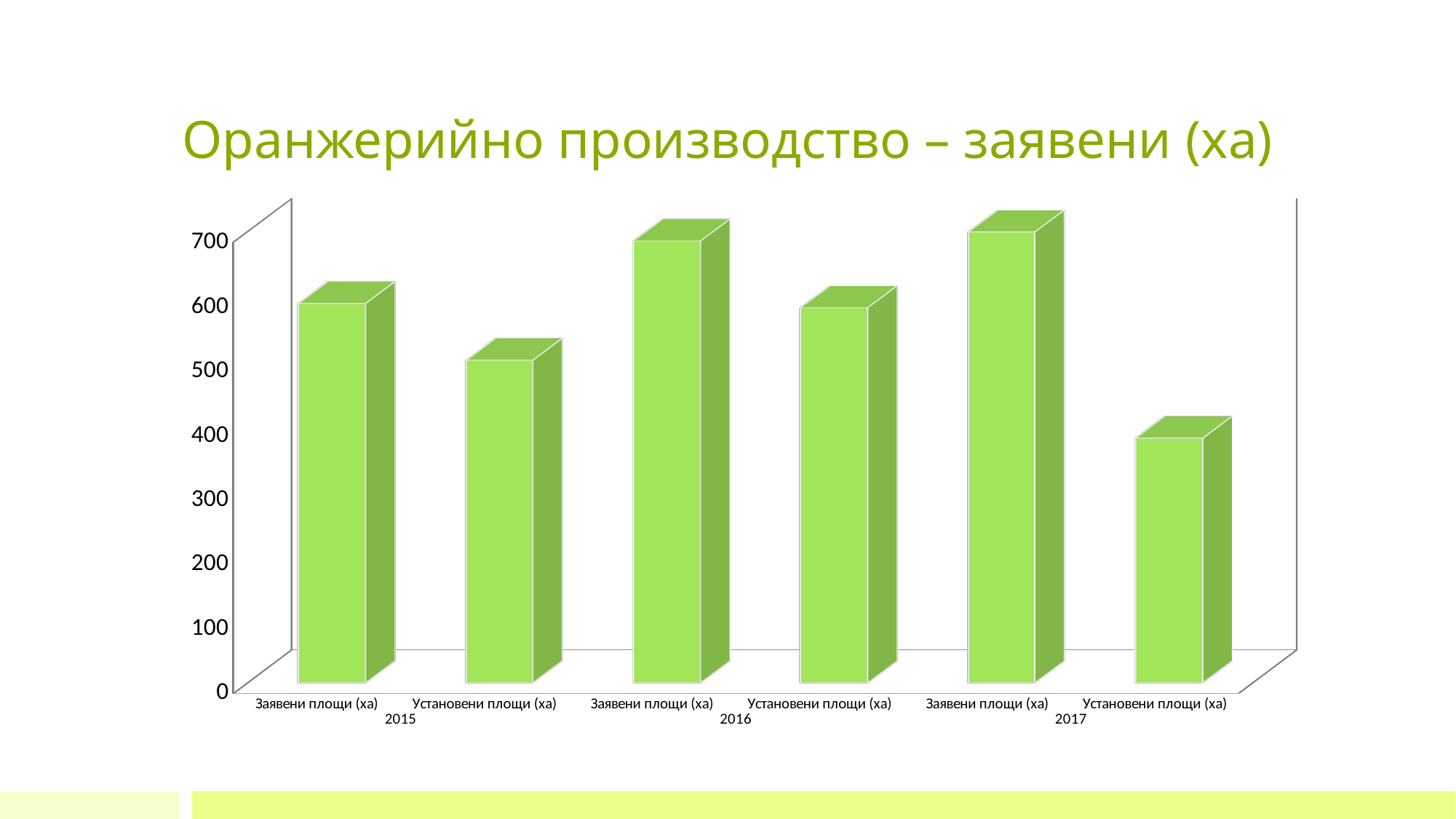
Which is larger in 2017: Заявени площи (ха) or Установени площи (ха)? Заявени площи (ха) Which is larger: Заявени площи (ха) in 2015 or Заявени площи (ха) in 2016? Заявени площи (ха) in 2016 How many bars are plotted in the chart? 6 Which is larger: Установени площи (ха) in 2015 or Установени площи (ха) in 2016? Установени площи (ха) in 2016 What kind of chart is shown on the slide? bar chart Which bar has the lowest value? Установени площи (ха) 2017 Is the value for Установени площи (ха) in 2016 greater or less than 500? greater What is the title of the chart? Оранжерийно производство – заявени (ха) Is the value for Установени площи (ха) in 2017 greater or less than 500? less Is the value for Заявени площи (ха) in 2016 greater or less than 600? greater